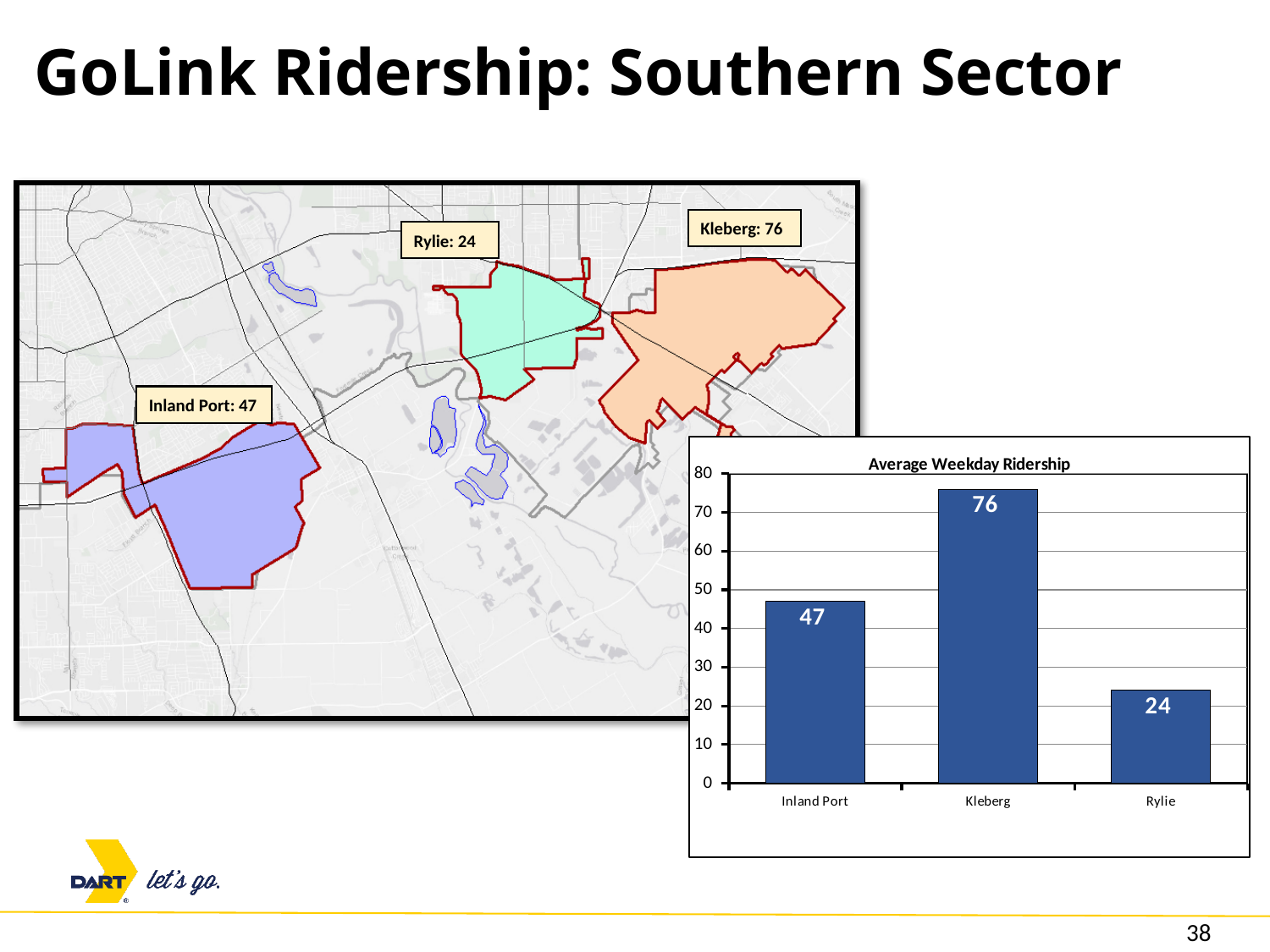
What is the average weekday ridership for Kleberg? 76 Is the average weekday ridership for Kleberg greater or less than 70? greater How many zones are shown in the Average Weekday Ridership chart? 3 What is the difference in average weekday ridership between Inland Port and Rylie? 23 What is the average weekday ridership for Inland Port? 47 Which zone has the lowest average weekday ridership? Rylie What type of chart is used to show Average Weekday Ridership? Bar chart What is the title of the chart on the slide? Average Weekday Ridership Which has higher average weekday ridership, Inland Port or Rylie? Inland Port Which zone has the highest average weekday ridership? Kleberg What is the average weekday ridership for Rylie? 24 What is the difference in average weekday ridership between Kleberg and Inland Port? 29